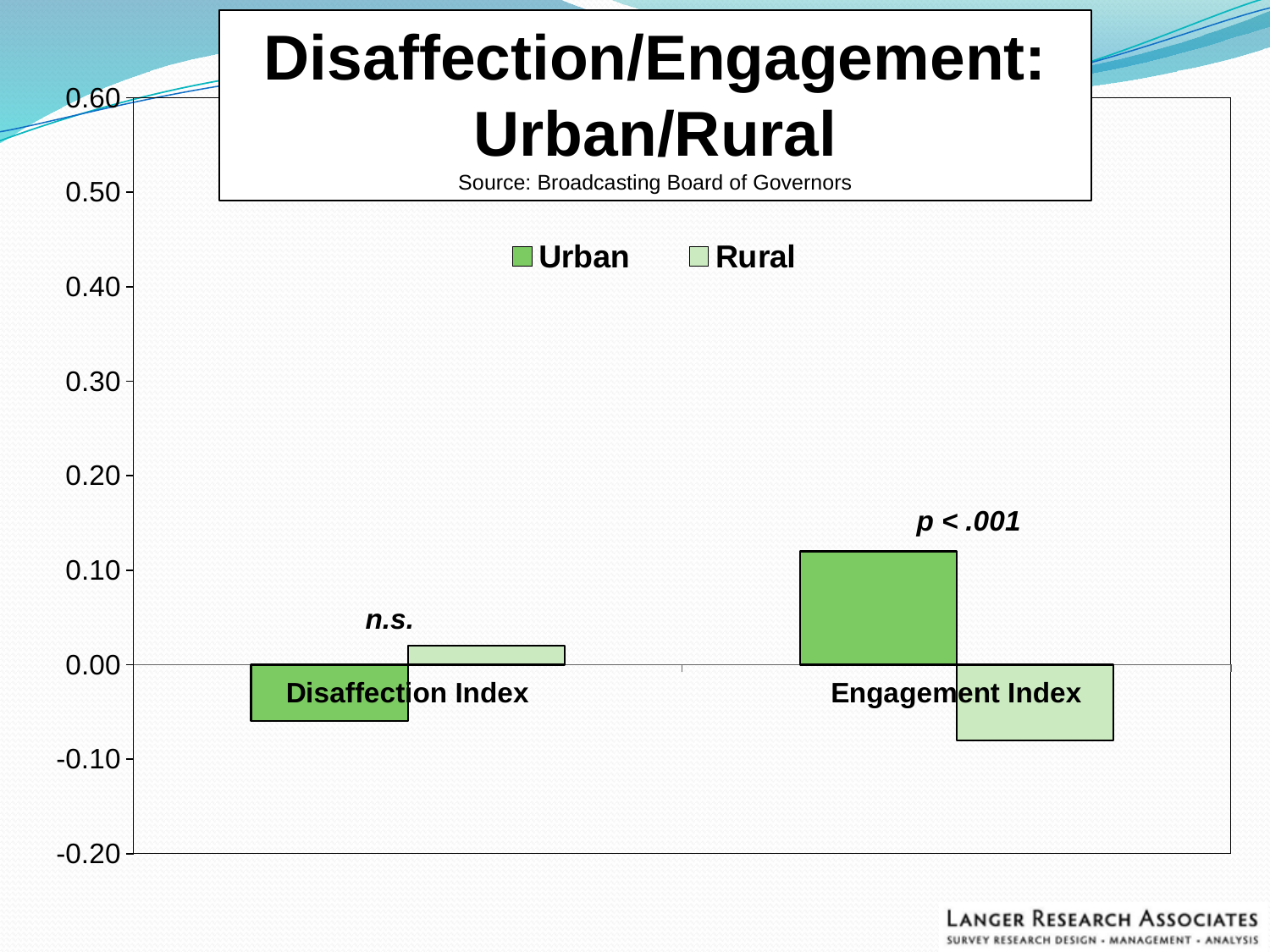
Which bar has the highest value in the chart? Urban, Engagement Index Is the Urban value for the Engagement Index greater or less than 0.10? greater Is the Rural value for the Disaffection Index greater or less than 0.00? greater For the Engagement Index, which is larger, the Urban value or the Rural value? Urban How many categories are shown on the x axis? 2 For the Disaffection Index, which is larger, the Urban value or the Rural value? Rural What significance annotation is printed above the Engagement Index bars? p < .001 What kind of chart is shown on the slide? bar chart How many series does the legend list? 2 What is the title of the chart? Disaffection/Engagement: Urban/Rural Is the Urban value for the Disaffection Index greater or less than 0.00? less